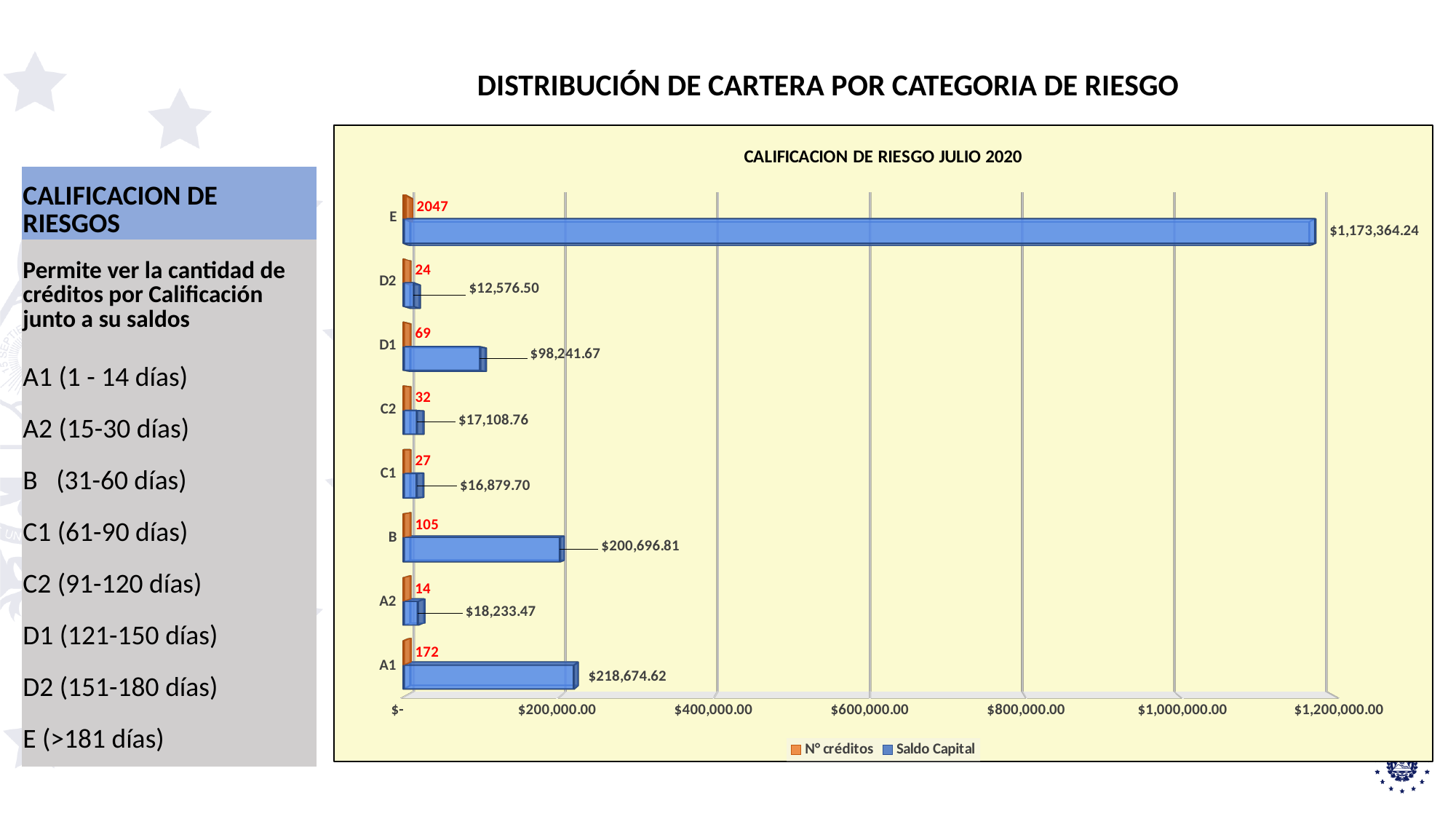
Which category has the lowest Saldo Capital? D2 What is the difference in N° créditos between E and A1? 1875 What is the difference in Saldo Capital between A1 and B? $17,977.81 How many risk categories are plotted on the chart? 8 How many N° créditos are shown for category B? 105 Which category has the highest Saldo Capital? E What is the Saldo Capital value for category E? $1,173,364.24 Which has a larger Saldo Capital, C2 or C1? C2 What kind of chart is shown on the slide? Bar chart What is the Saldo Capital value for category D1? $98,241.67 How many series does the legend list? 2 Which category has the lowest N° créditos? A2